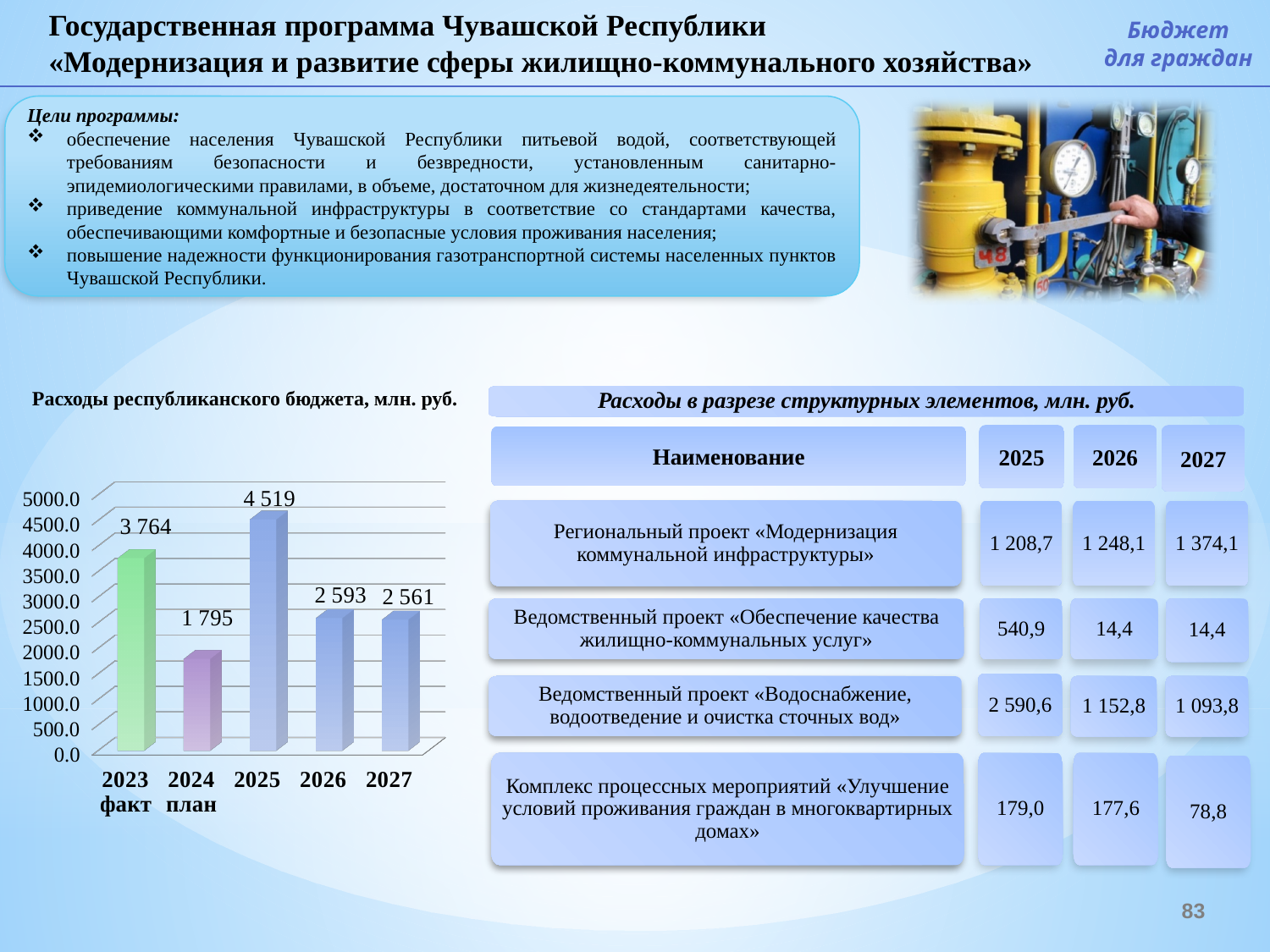
How many years (categories) are shown in the chart 'Расходы республиканского бюджета, млн. руб.'? 5 Which year has the highest value in the chart 'Расходы республиканского бюджета, млн. руб.'? 2025 What is the value for 2027 in the chart 'Расходы республиканского бюджета, млн. руб.'? 2 561 What is the value for 2024 (план) in the chart 'Расходы республиканского бюджета, млн. руб.'? 1 795 In the chart 'Расходы республиканского бюджета, млн. руб.', is the value for 2026 greater or less than 3000.0? less What is the value for 2023 (факт) in the chart 'Расходы республиканского бюджета, млн. руб.'? 3 764 What is the value for 2025 in the chart 'Расходы республиканского бюджета, млн. руб.'? 4 519 In the chart 'Расходы республиканского бюджета, млн. руб.', does the value rise or fall from 2026 to 2027? fall Which year has the lowest value in the chart 'Расходы республиканского бюджета, млн. руб.'? 2024 In the chart 'Расходы республиканского бюджета, млн. руб.', which is larger: the value for 2023 or the value for 2026? 2023 What type of chart is used to show the republican budget expenditures (Расходы республиканского бюджета, млн. руб.)? bar chart In the chart 'Расходы республиканского бюджета, млн. руб.', what is the difference between the values for 2025 and 2024? 2 724